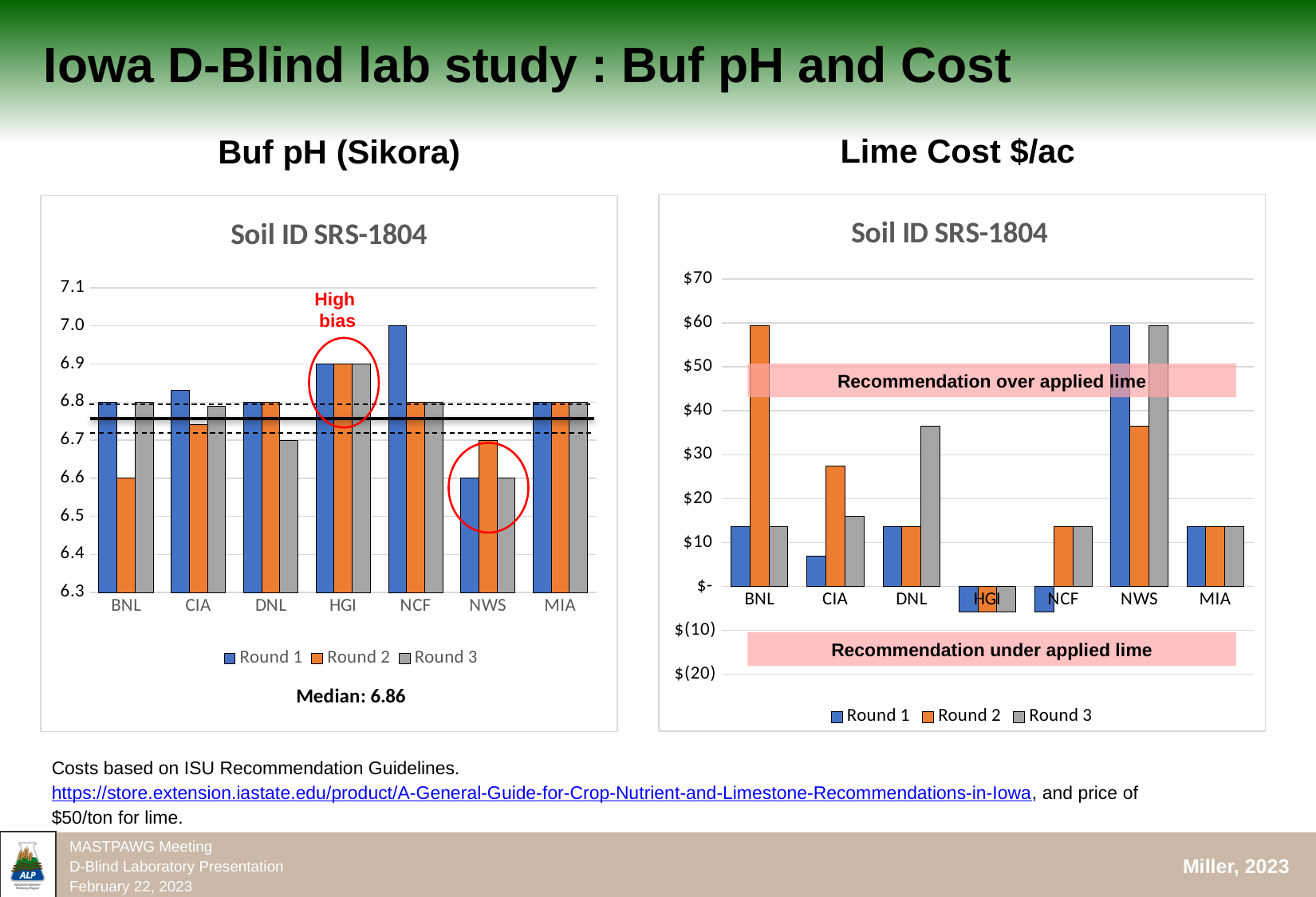
What kind of chart is the Buf pH (Sikora) chart on the left? bar chart How many series does the legend of the Lime Cost $/ac chart on the right list? 3 In the Lime Cost $/ac chart on the right, is the Round 2 value for BNL greater or less than $50? greater In the Buf pH (Sikora) chart on the left, which category has the lowest Round 3 value? NWS In the Buf pH (Sikora) chart on the left, is the Round 2 value for BNL greater or less than 6.7? less In the Lime Cost $/ac chart on the right, which category has the lowest Round 2 value? HGI In the Lime Cost $/ac chart on the right, is the Round 3 value for DNL greater or less than $30? greater In the Lime Cost $/ac chart on the right, which is larger for CIA: the Round 2 value or the Round 3 value? Round 2 In the Buf pH (Sikora) chart on the left, which category has the highest Round 1 value? NCF What median value is printed below the Buf pH (Sikora) chart on the left? 6.86 How many soil categories are shown on the x axis of the Buf pH (Sikora) chart on the left? 7